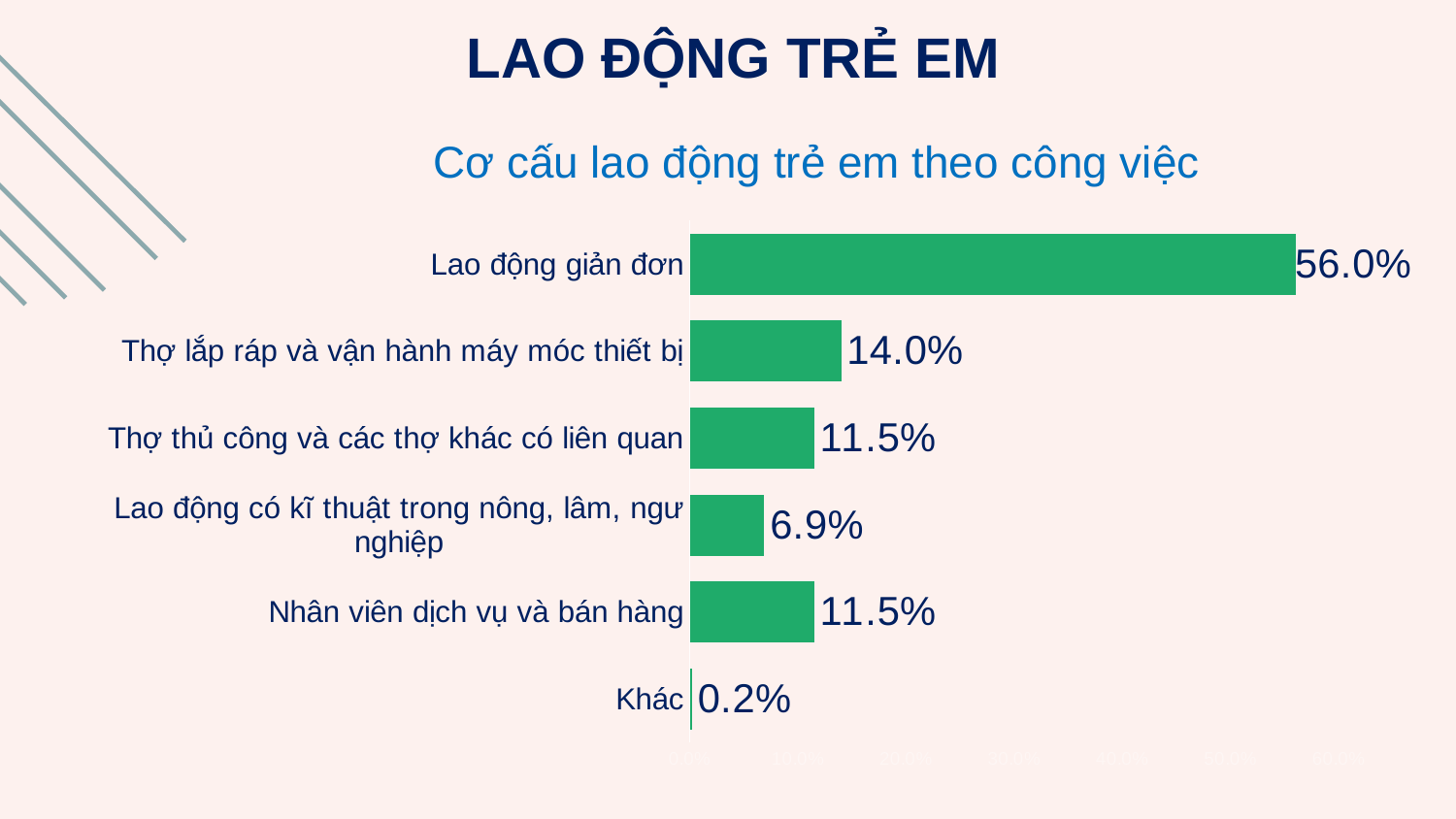
What kind of chart is shown on the slide? Bar chart What is the value for Lao động có kĩ thuật trong nông, lâm, ngư nghiệp? 6.9% What is the title of the chart? Cơ cấu lao động trẻ em theo công việc What is the value for Lao động giản đơn? 56.0% What is the difference between the values for Lao động giản đơn and Thợ lắp ráp và vận hành máy móc thiết bị? 42.0% Which category has the highest value? Lao động giản đơn What colour are the bars in the chart? Green What is the value for Thợ lắp ráp và vận hành máy móc thiết bị? 14.0% Which is larger, the value for Thợ lắp ráp và vận hành máy móc thiết bị or the value for Nhân viên dịch vụ và bán hàng? Thợ lắp ráp và vận hành máy móc thiết bị Which category has the lowest value? Khác What is the value for Khác? 0.2% How many categories are shown in the chart? 6